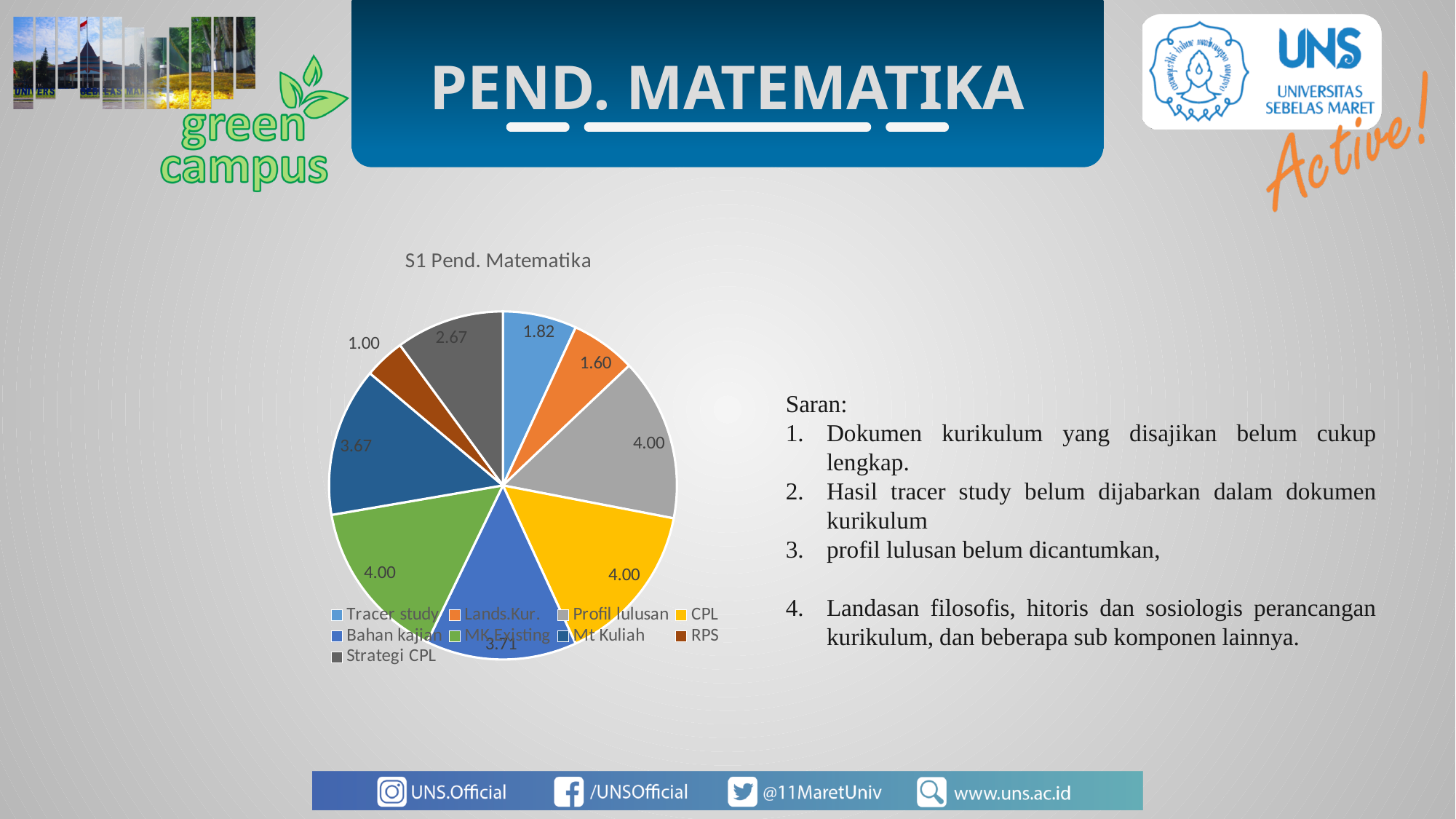
Which category has the lowest value in the pie chart? RPS Which is larger, the value for Strategi CPL or the value for RPS? Strategi CPL What is the value for Tracer study in the pie chart? 1.82 What is the value for Mt Kuliah in the pie chart? 3.67 What is the value for Bahan kajian in the pie chart? 3.71 What is the value for Strategi CPL in the pie chart? 2.67 What is the difference between the values for Strategi CPL and RPS? 1.67 How many categories does the legend of the pie chart list? 9 What type of chart is shown on the slide? Pie chart What is the difference between the values for Tracer study and Lands.Kur.? 0.22 What is the title of the chart? S1 Pend. Matematika What is the value for Lands.Kur. in the pie chart? 1.60